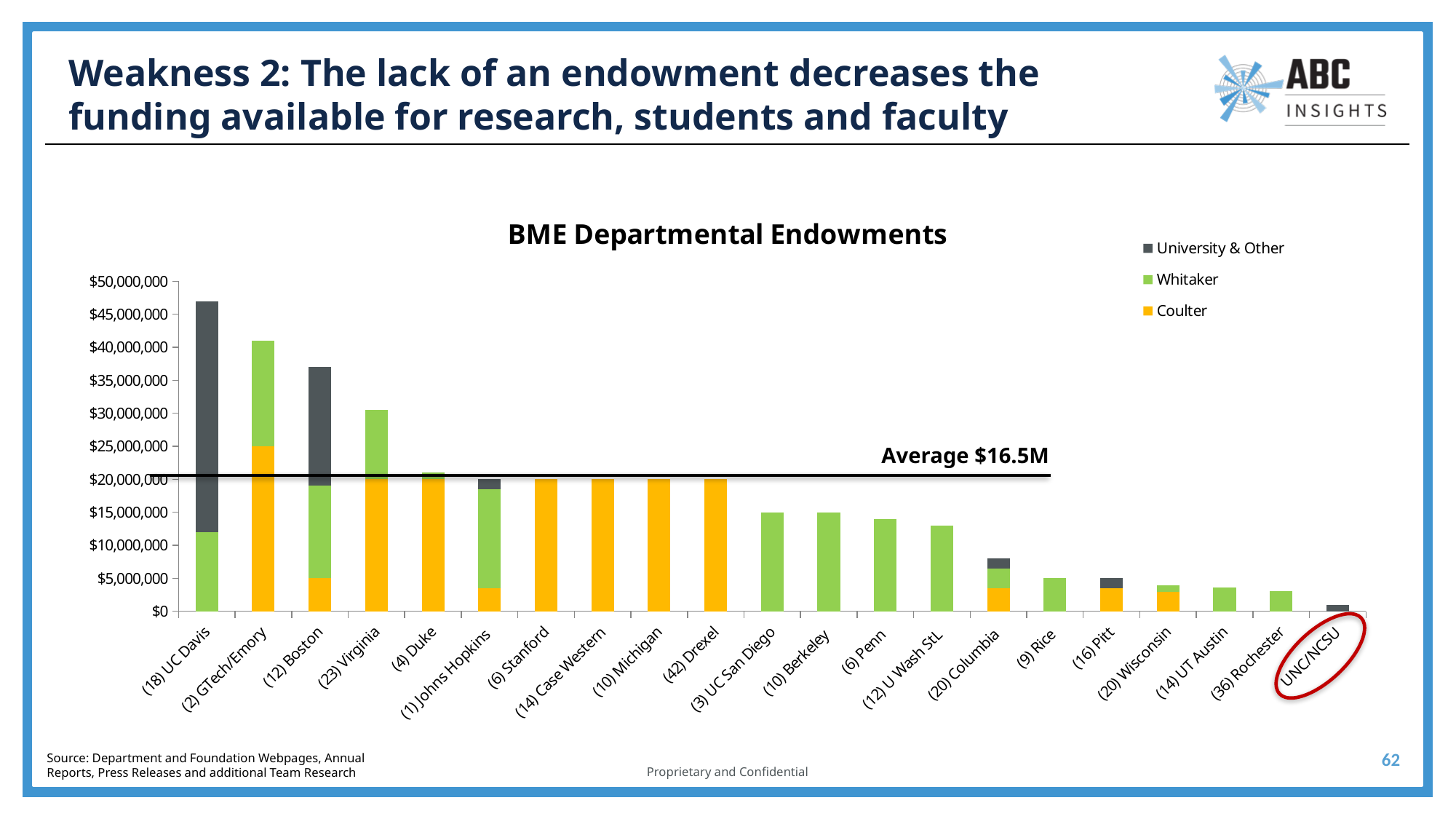
What is the title of the chart? BME Departmental Endowments Is the total endowment for (18) UC Davis greater or less than $45,000,000? greater What is the total endowment shown for (6) Stanford? $20,000,000 What kind of chart is shown on the slide? bar chart Which has the larger total endowment, (18) UC Davis or (12) Boston? (18) UC Davis How many institutions are shown on the x axis of the chart? 21 Which institution has the highest total endowment in the chart? (18) UC Davis How many series does the legend list? 3 Which institution has the lowest total endowment in the chart? UNC/NCSU Is the total endowment for (36) Rochester greater or less than $5,000,000? less What is the total endowment shown for (9) Rice? $5,000,000 What average value is labelled on the horizontal line across the chart? Average $16.5M